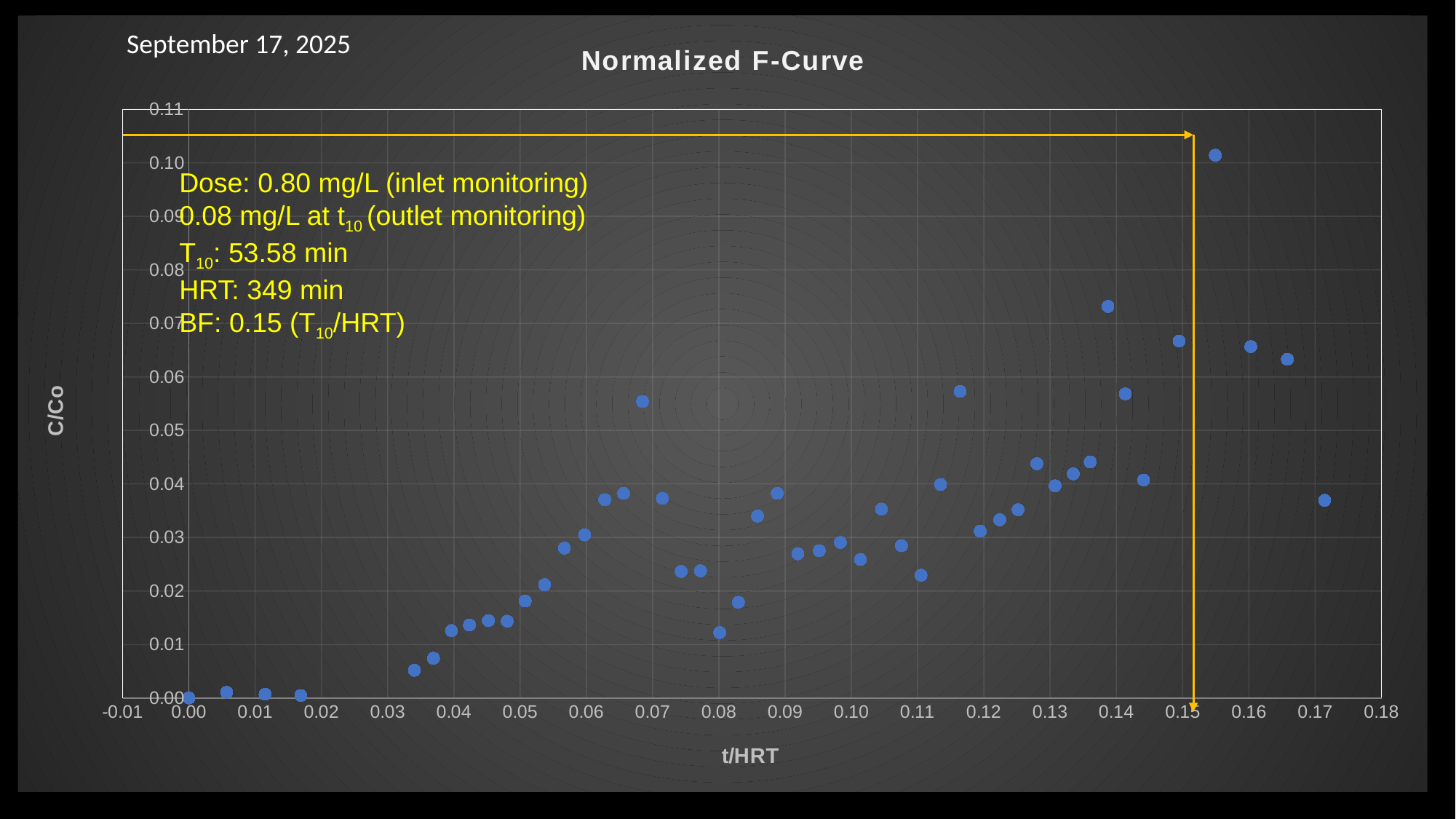
What is the label of the x axis of the chart? t/HRT Is the C/Co value of the point at t/HRT = 0.16 greater or less than 0.05? greater What is the title of the chart? Normalized F-Curve Is the C/Co value of the point at t/HRT = 0.10 greater or less than 0.04? less What kind of chart is shown on the slide? scatter chart Do the C/Co values generally rise or fall as t/HRT increases? rise What is the C/Co value of the point at t/HRT = 0.00? 0.00 Which has the larger C/Co value: the point at t/HRT = 0.00 or the point at t/HRT = 0.17? the point at t/HRT = 0.17